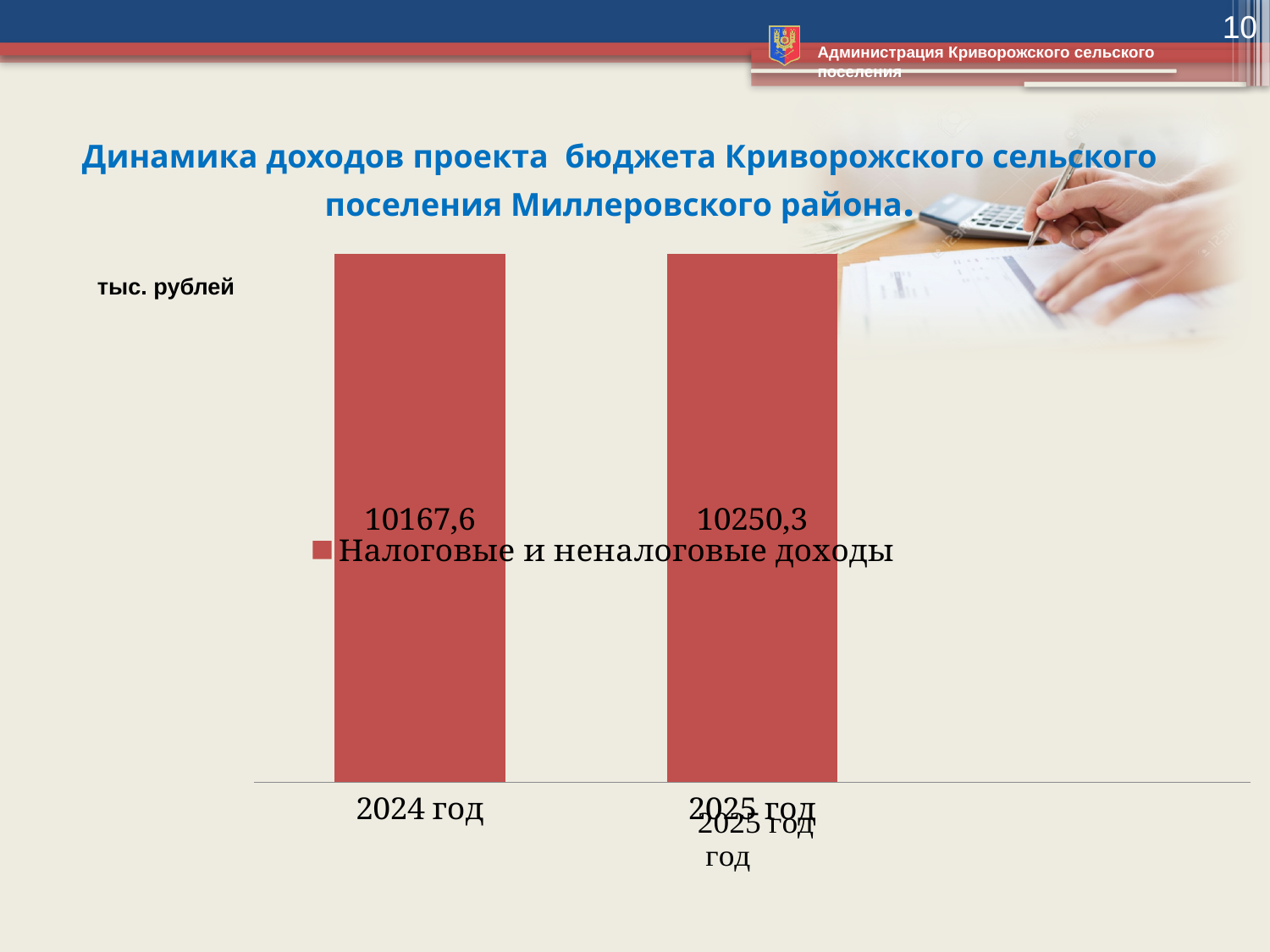
What is the difference between the values for 2025 год and 2024 год? 82,7 Do the values rise or fall from 2024 год to 2025 год? rise What unit of measurement is indicated for the chart? тыс. рублей What is the value for 2025 год? 10250,3 How many bars are shown in the chart? 2 Which year has the higher value, 2024 год or 2025 год? 2025 год How many series does the legend list? 1 What kind of chart is shown on the slide? bar chart What series name is shown in the chart legend? Налоговые и неналоговые доходы Which year has the lowest value? 2024 год Which year has the highest value? 2025 год What is the value for 2024 год? 10167,6